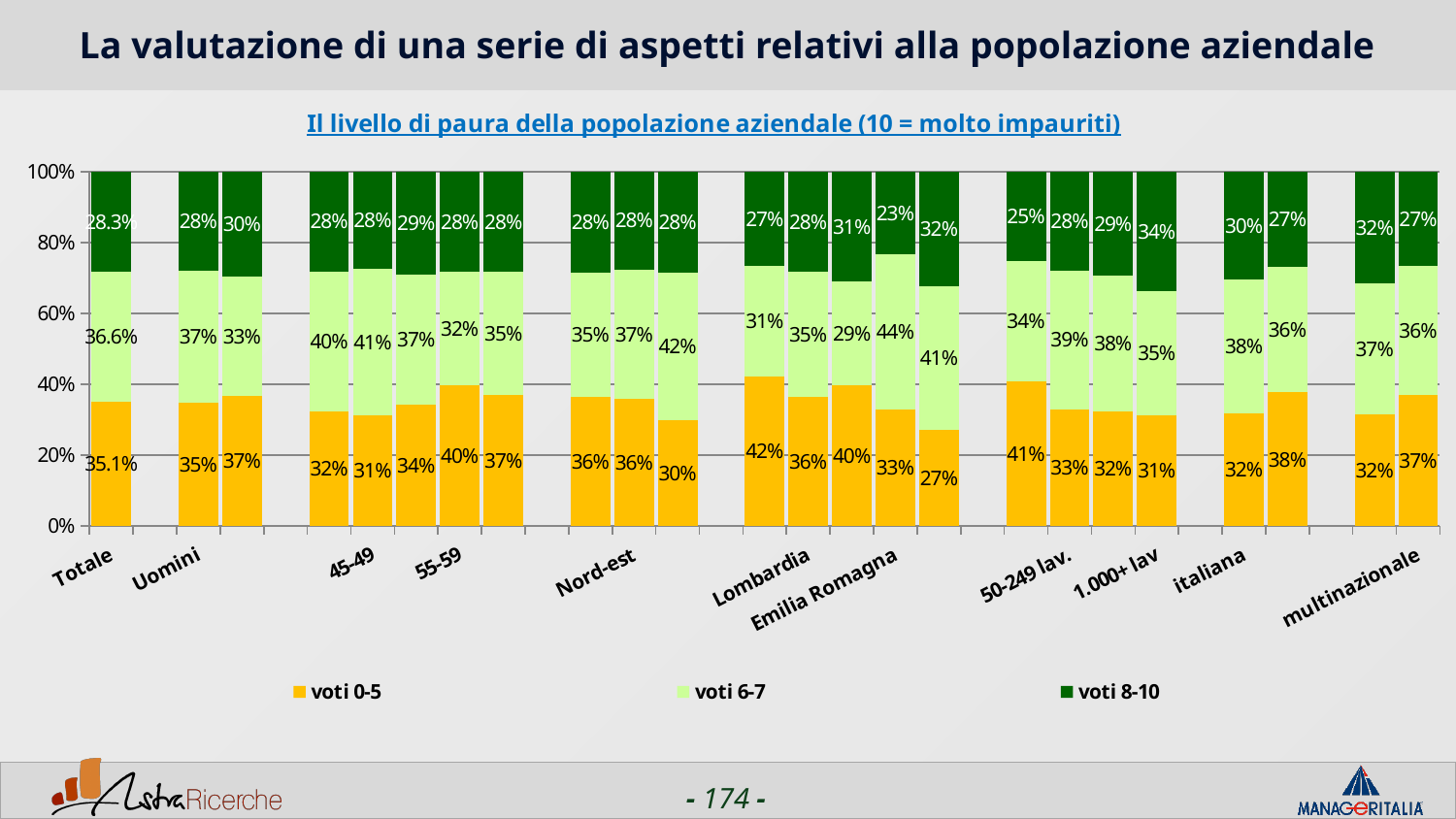
What is the value of voti 8-10 for Totale? 28.3% How many series does the legend list? 3 What is the title of the chart? Il livello di paura della popolazione aziendale (10 = molto impauriti) What is the value of voti 6-7 for Uomini? 37% What is the value of voti 6-7 for Totale? 36.6% What kind of chart is shown on the slide? stacked bar chart What is the value of voti 8-10 for 1.000+ lav? 34% What are the three series listed in the legend? voti 0-5, voti 6-7, voti 8-10 What is the value of voti 8-10 for Emilia Romagna? 23% What is the value of voti 0-5 for Totale? 35.1% For Totale, which is larger: voti 6-7 or voti 0-5? voti 6-7 For Totale, what is the difference between voti 6-7 and voti 0-5? 1.5 percentage points